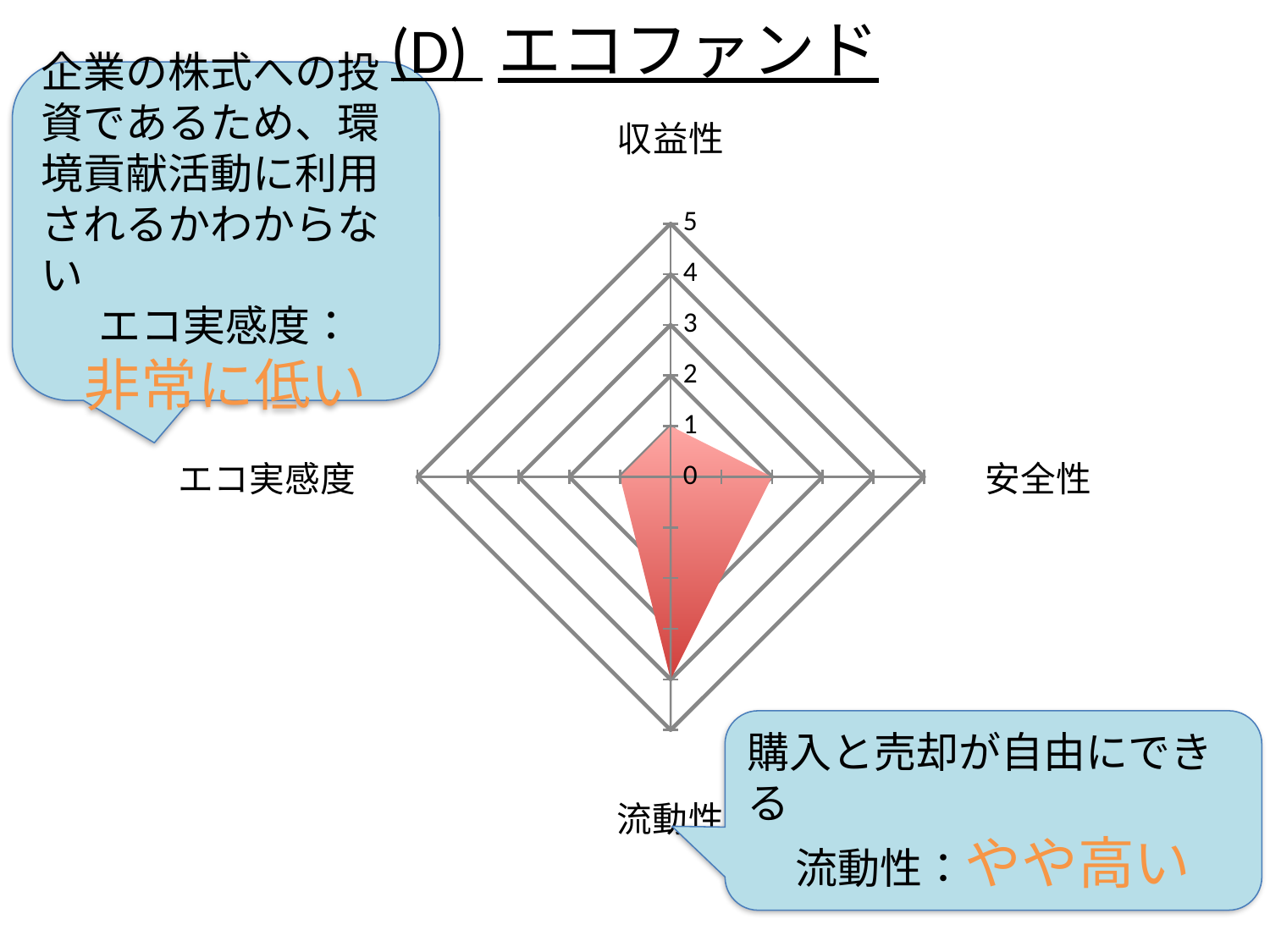
What is the value for 収益性 on the radar chart? 1 What is the maximum value shown on the radar chart's axis scale? 5 What is the value for エコ実感度 on the radar chart? 1 What is the title of the slide containing the chart? (D) エコファンド Which is larger, the value for 流動性 or the value for 安全性? 流動性 Is the value for 流動性 greater or less than 3? greater What is the difference between the value for 流動性 and the value for 安全性? 2 What kind of chart is shown on the slide? radar chart What is the value for 流動性 on the radar chart? 4 How many categories (axes) does the radar chart have? 4 What is the value for 安全性 on the radar chart? 2 Which category has the highest value on the radar chart? 流動性